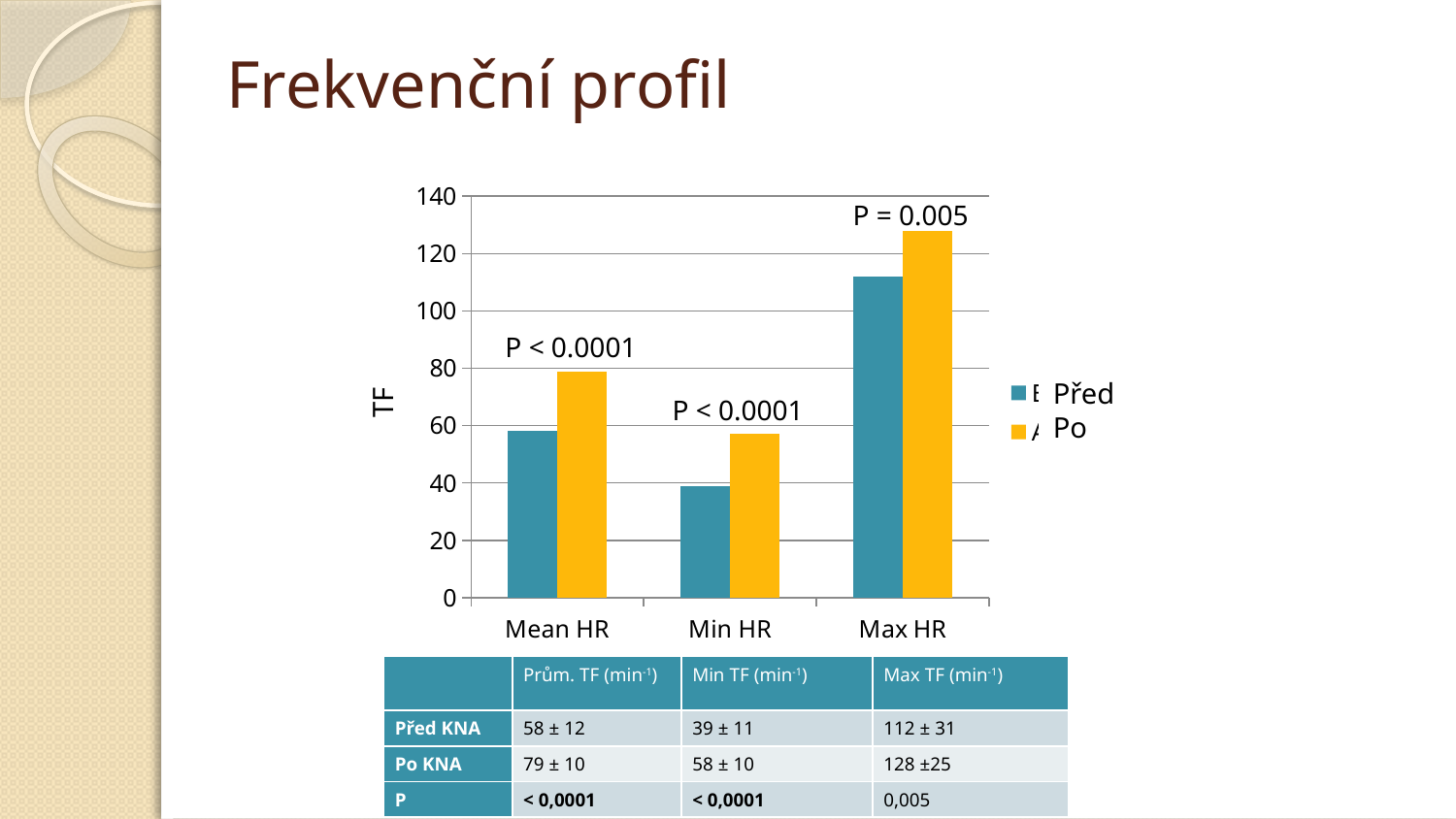
For Max HR, which series has the larger value, Před or Po? Po Which category has the lowest bar for the Před series? Min HR How many series does the chart's legend list? 2 Which category has the highest bar for the Po series? Max HR What is the label on the vertical axis of the chart? TF What kind of chart is shown on the slide? bar chart What P value is printed above the Max HR bars in the chart? P = 0.005 Is the Po value for Max HR greater or less than 120? greater For Min HR, which series has the smaller value, Před or Po? Před How many categories are shown on the x axis of the chart? 3